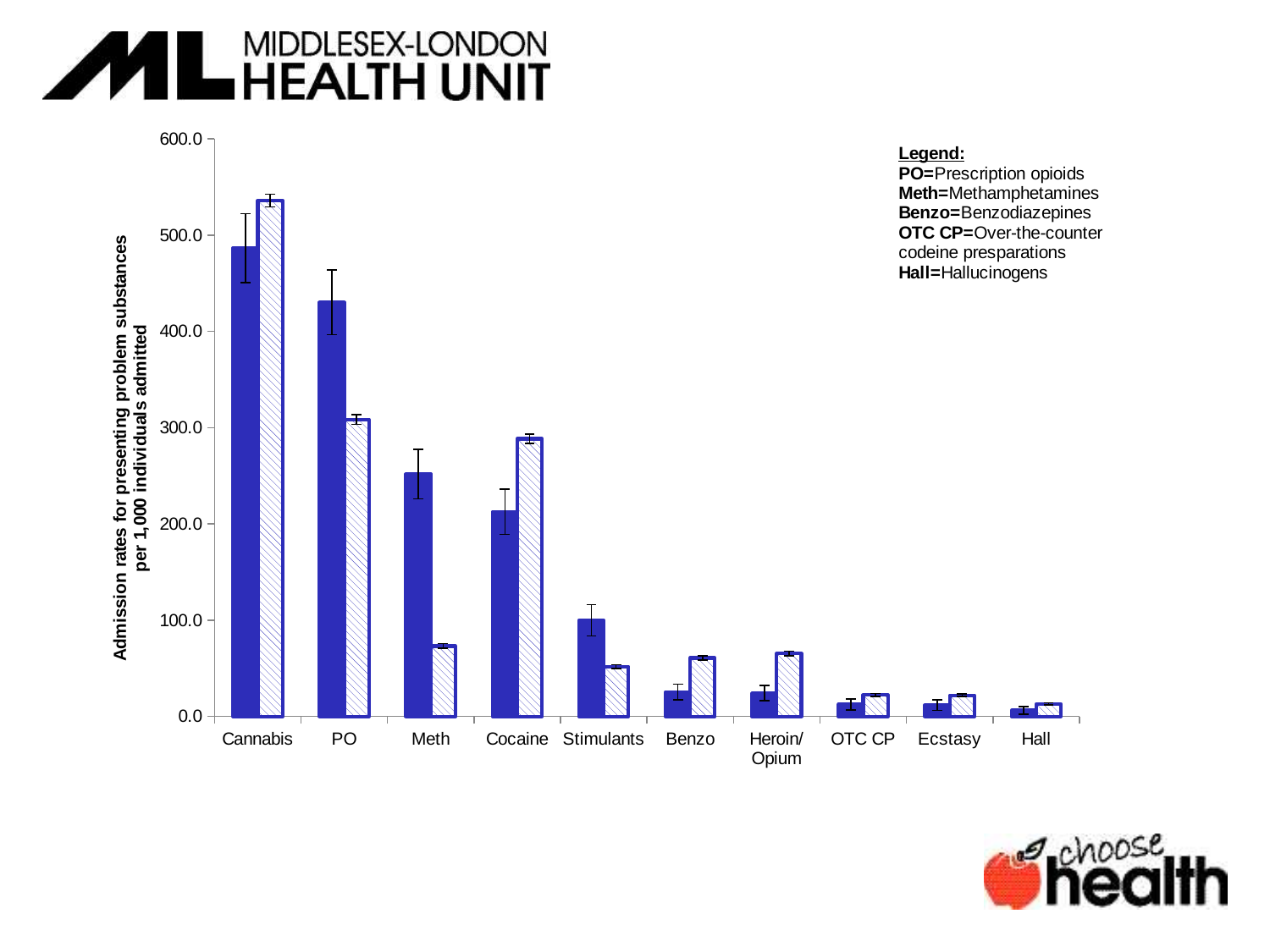
Is the solid blue bar for Cannabis greater or less than 400? greater For Meth, which bar is taller, the solid blue bar or the hatched bar? the solid blue bar Do the admission rates generally rise or fall moving from left to right across the categories? fall Is the hatched bar for Cannabis greater or less than 500? greater For Cocaine, which bar is taller, the solid blue bar or the hatched bar? the hatched bar Is the solid blue bar for PO greater or less than 400? greater Which category has the lowest bars in the chart? Hall What kind of chart is shown on the slide? bar chart Which category has the tallest bar in the chart? Cannabis According to the legend text on the slide, what does PO stand for? Prescription opioids How many substance categories are shown on the x axis of the chart? 10